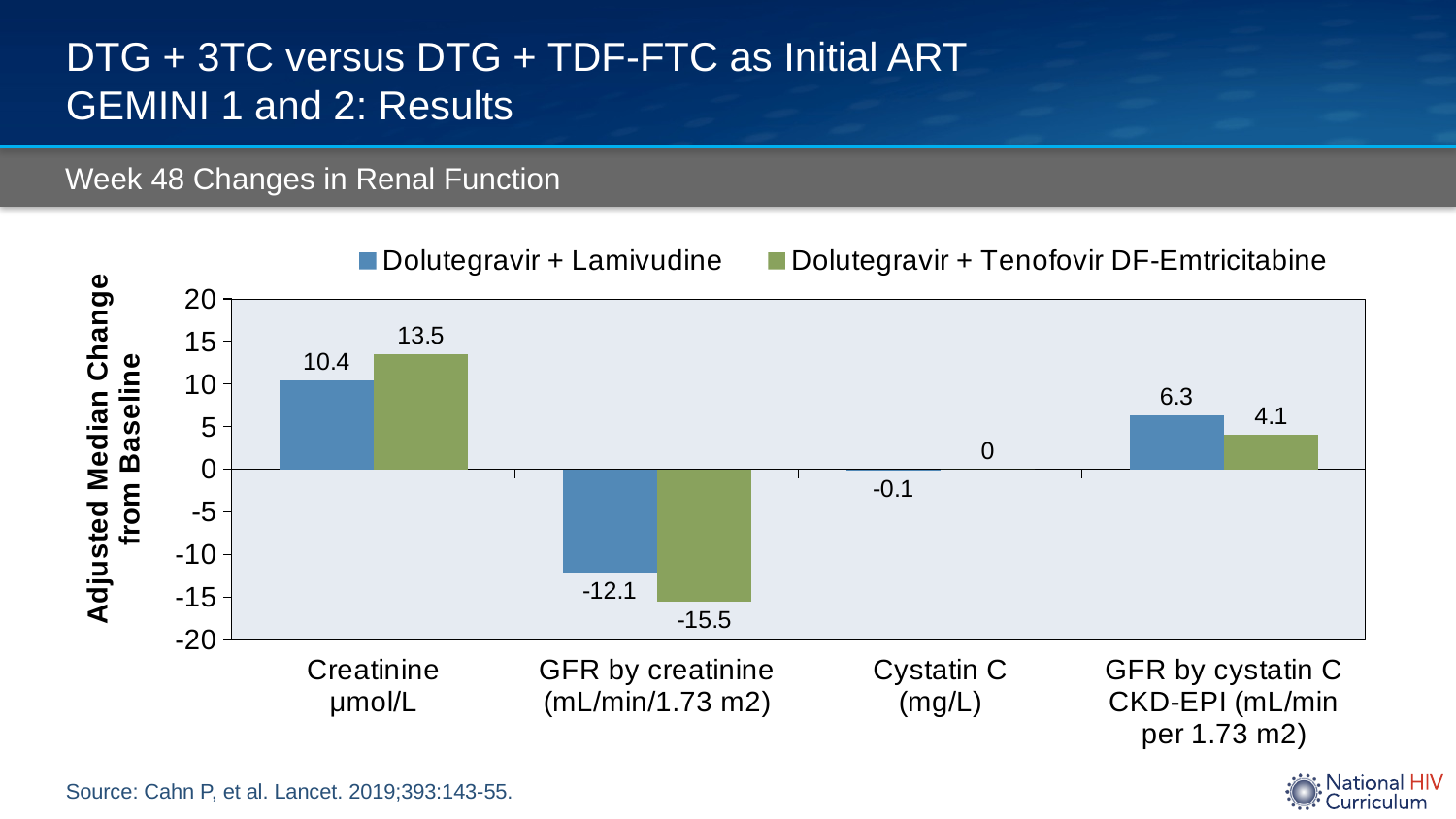
What is the adjusted median change from baseline in creatinine (µmol/L) for Dolutegravir + Lamivudine? 10.4 How many categories are shown on the x axis? 4 How many series does the legend list? 2 What is the difference between the two series' values for creatinine (µmol/L)? 3.1 What kind of chart is shown on the slide? Bar chart For GFR by cystatin C CKD-EPI, which series has the larger value? Dolutegravir + Lamivudine What is the adjusted median change from baseline in cystatin C (mg/L) for Dolutegravir + Lamivudine? -0.1 What is the y-axis label of the chart? Adjusted Median Change from Baseline What is the adjusted median change from baseline in GFR by cystatin C CKD-EPI for Dolutegravir + Tenofovir DF-Emtricitabine? 4.1 What is the adjusted median change from baseline in GFR by creatinine for Dolutegravir + Tenofovir DF-Emtricitabine? -15.5 Which category has the highest value for Dolutegravir + Tenofovir DF-Emtricitabine? Creatinine µmol/L Which category has the lowest value for Dolutegravir + Lamivudine? GFR by creatinine (mL/min/1.73 m2)